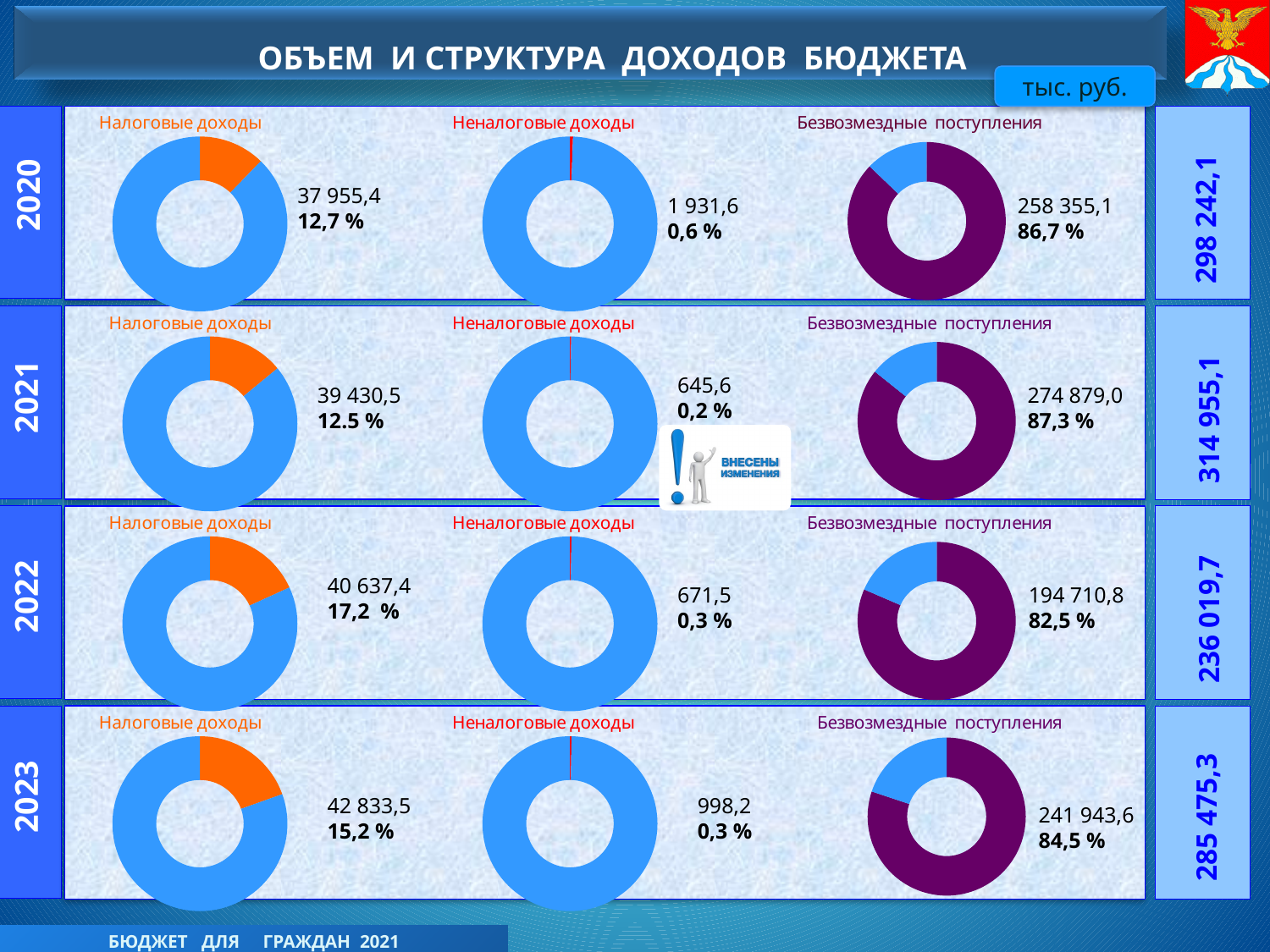
On the 2023 'Налоговые доходы' donut chart, what percentage is shown? 15,2 % What kind of chart is used for 'Неналоговые доходы' in the 2023 row? donut (pie) chart Is the value on the 2021 'Налоговые доходы' donut chart larger or smaller than the value on the 2020 'Налоговые доходы' donut chart? larger Which of the three 2020 donut charts shows the smallest share: 'Налоговые доходы', 'Неналоговые доходы' or 'Безвозмездные поступления'? Неналоговые доходы Which of the three 2022 donut charts shows the largest share: 'Налоговые доходы', 'Неналоговые доходы' or 'Безвозмездные поступления'? Безвозмездные поступления On the 2020 'Налоговые доходы' donut chart, what share of the total does the highlighted slice represent? 12,7 % On the 2023 'Безвозмездные поступления' donut chart, what value is printed next to the chart? 241 943,6 On the 2022 'Неналоговые доходы' donut chart, what value is printed next to the chart? 671,5 On the 2020 'Налоговые доходы' donut chart, what value is printed next to the chart? 37 955,4 On the 2021 'Безвозмездные поступления' donut chart, what value is printed next to the chart? 274 879,0 How many donut charts are shown on the slide in total? 12 On the 2021 'Безвозмездные поступления' donut chart, what percentage is shown? 87,3 %